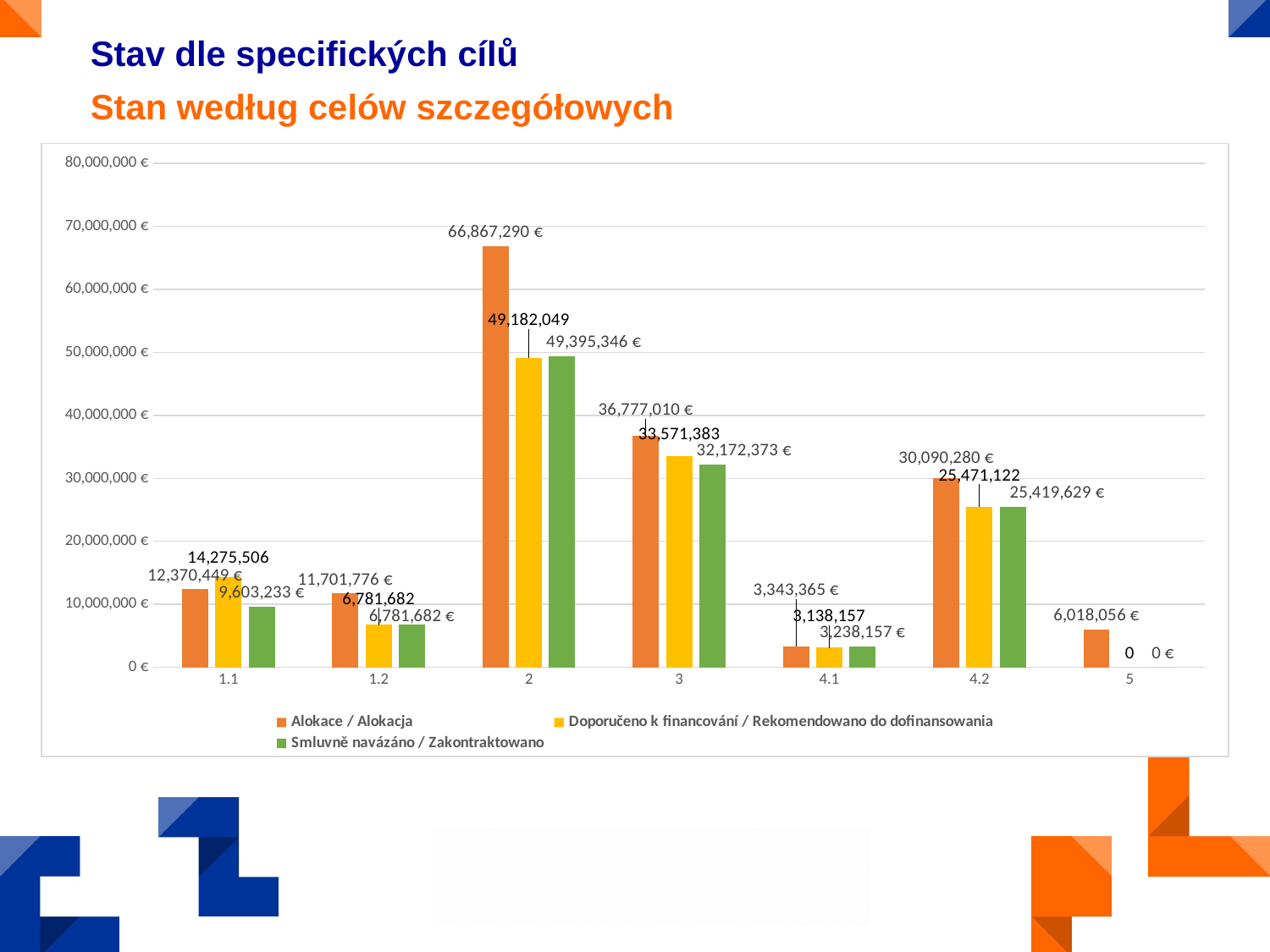
How many categories are shown on the x axis? 7 Is the Alokace / Alokacja value for category 4.2 greater or less than 20,000,000 €? greater Which category has the larger Alokace / Alokacja value, 1.1 or 1.2? 1.1 What is the difference between the Alokace / Alokacja value and the Doporučeno k financování / Rekomendowano do dofinansowania value for category 2? 17,685,241 € What kind of chart is shown on the slide? bar chart Which category has the highest Alokace / Alokacja value? 2 How many series does the legend list? 3 What is the Doporučeno k financování / Rekomendowano do dofinansowania value for category 4.2? 25,471,122 What colour represents the Alokace / Alokacja series? orange What is the Alokace / Alokacja value for category 2? 66,867,290 € Which category has the lowest Alokace / Alokacja value? 4.1 What is the Smluvně navázáno / Zakontraktowano value for category 3? 32,172,373 €